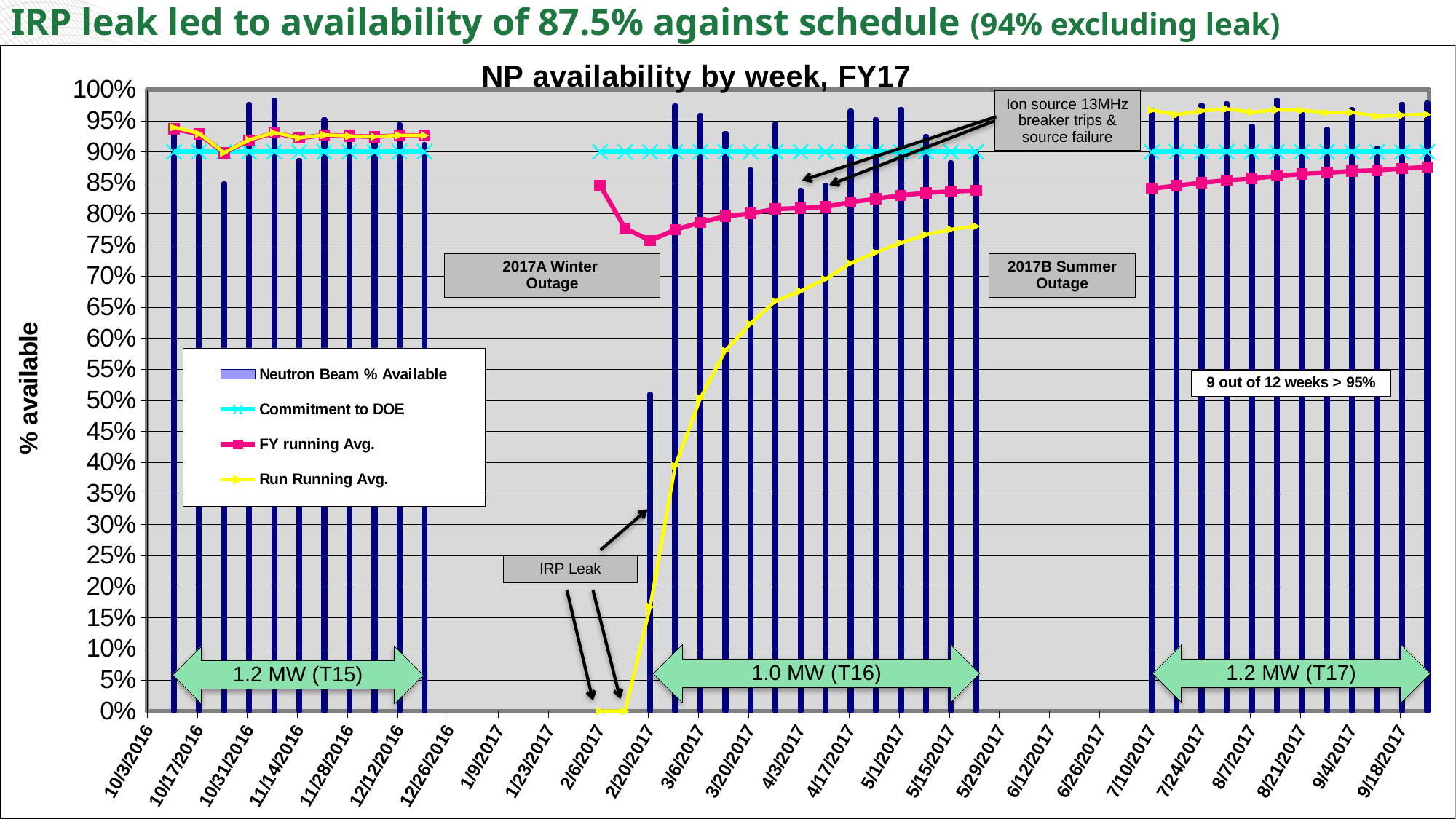
Which series is drawn in yellow in the legend? Run Running Avg. Is the Run Running Avg. value at 2/20/2017 greater or less than 30%? less Is the FY running Avg. value at 2/20/2017 greater or less than 80%? less What kind of chart is used to plot Neutron Beam % Available? bar chart Which is larger, the Neutron Beam % Available bar for 2/20/2017 or the bar for 3/6/2017? 3/6/2017 Is the Neutron Beam % Available bar for 2/20/2017 greater or less than 60%? less How many series does the chart legend list? 4 What value does the Commitment to DOE line sit at throughout the chart? 90% Does the Run Running Avg. line rise or fall between 2/20/2017 and 5/29/2017? rise What is the title of the chart? NP availability by week, FY17